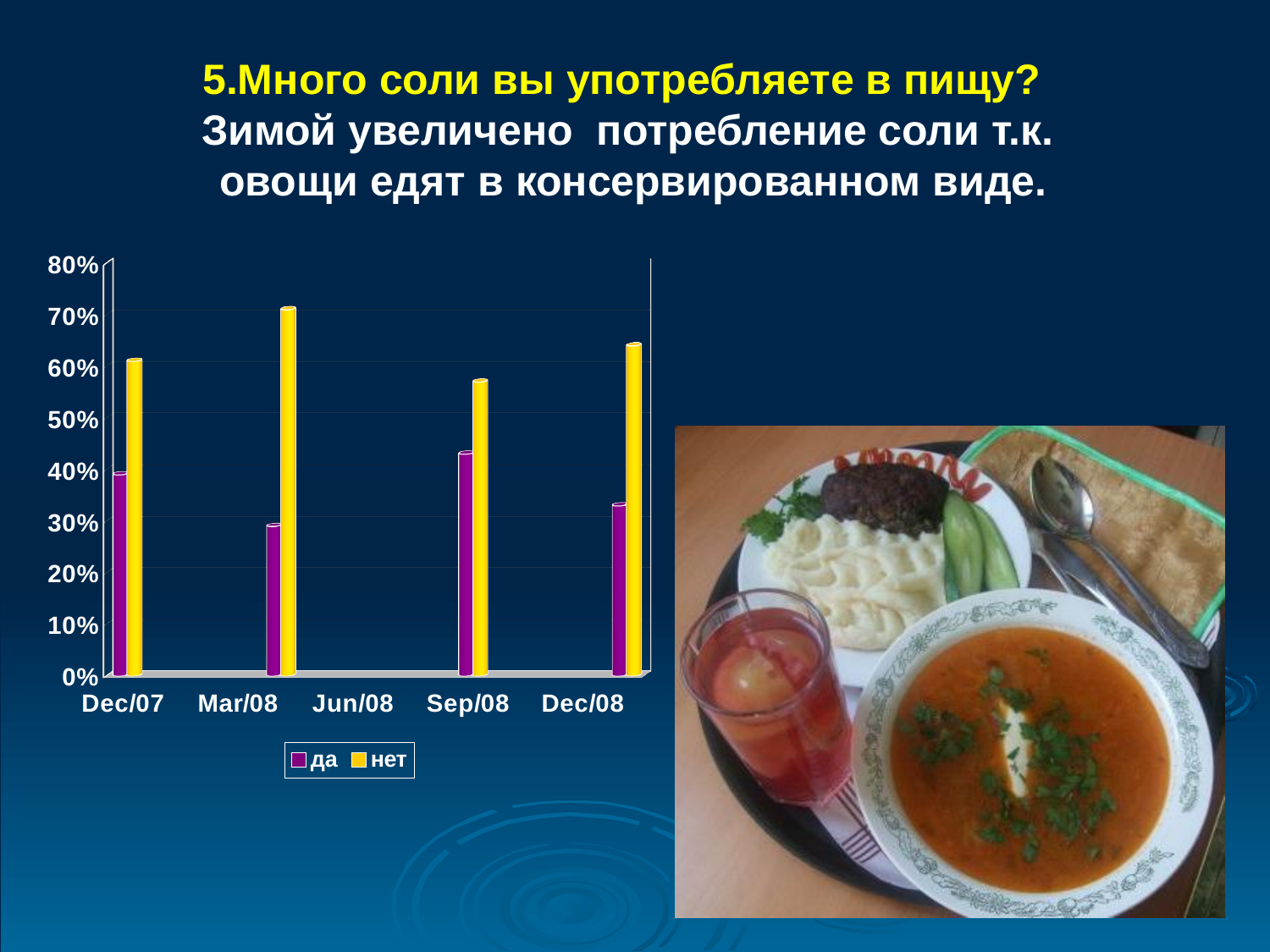
What kind of chart is shown on the slide? bar chart Is the value for "да" at Dec/08 greater or less than 40%? less What colour are the bars for the series "нет"? yellow At which date is the "да" bar the lowest? Mar/08 Is the value for "нет" at Sep/08 greater or less than 50%? greater Is the value for "да" at Mar/08 greater or less than 40%? less At which date is the "нет" bar the lowest? Sep/08 At Dec/07, which is larger, the "да" bar or the "нет" bar? нет At which date is the "нет" bar the highest? Mar/08 How many series does the legend list? 2 What are the two series named in the legend? да and нет